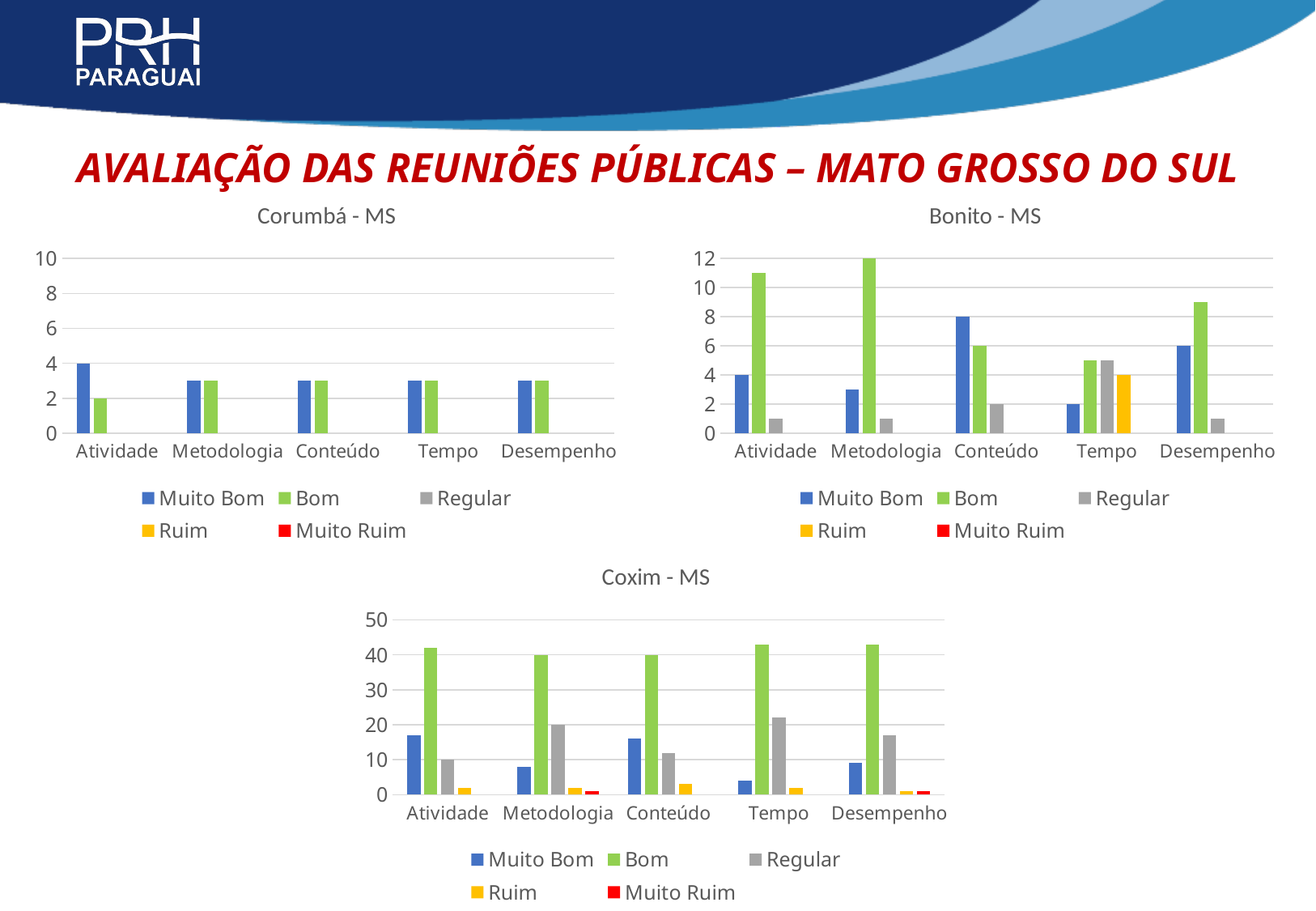
In the "Bonito - MS" chart, what is the value of Bom for Metodologia? 12 What kind of chart is the "Corumbá - MS" chart? bar chart In the "Corumbá - MS" chart, what is the value of Muito Bom for Atividade? 4 Which chart on the slide has the highest value on its vertical axis? Coxim - MS In the "Coxim - MS" chart, which category has the lowest Muito Bom value? Tempo In the "Coxim - MS" chart, is the value of Bom for Atividade greater or less than 40? greater In the "Coxim - MS" chart, what is the value of Regular for Metodologia? 20 In the "Bonito - MS" chart, what is the value of Muito Bom for Conteúdo? 8 How many categories are shown on the x axis of the "Coxim - MS" chart? 5 How many series does the legend of the "Bonito - MS" chart list? 5 In the "Bonito - MS" chart, which category has the highest Bom value? Metodologia In the "Bonito - MS" chart, which is larger for Tempo: Muito Bom or Ruim? Ruim